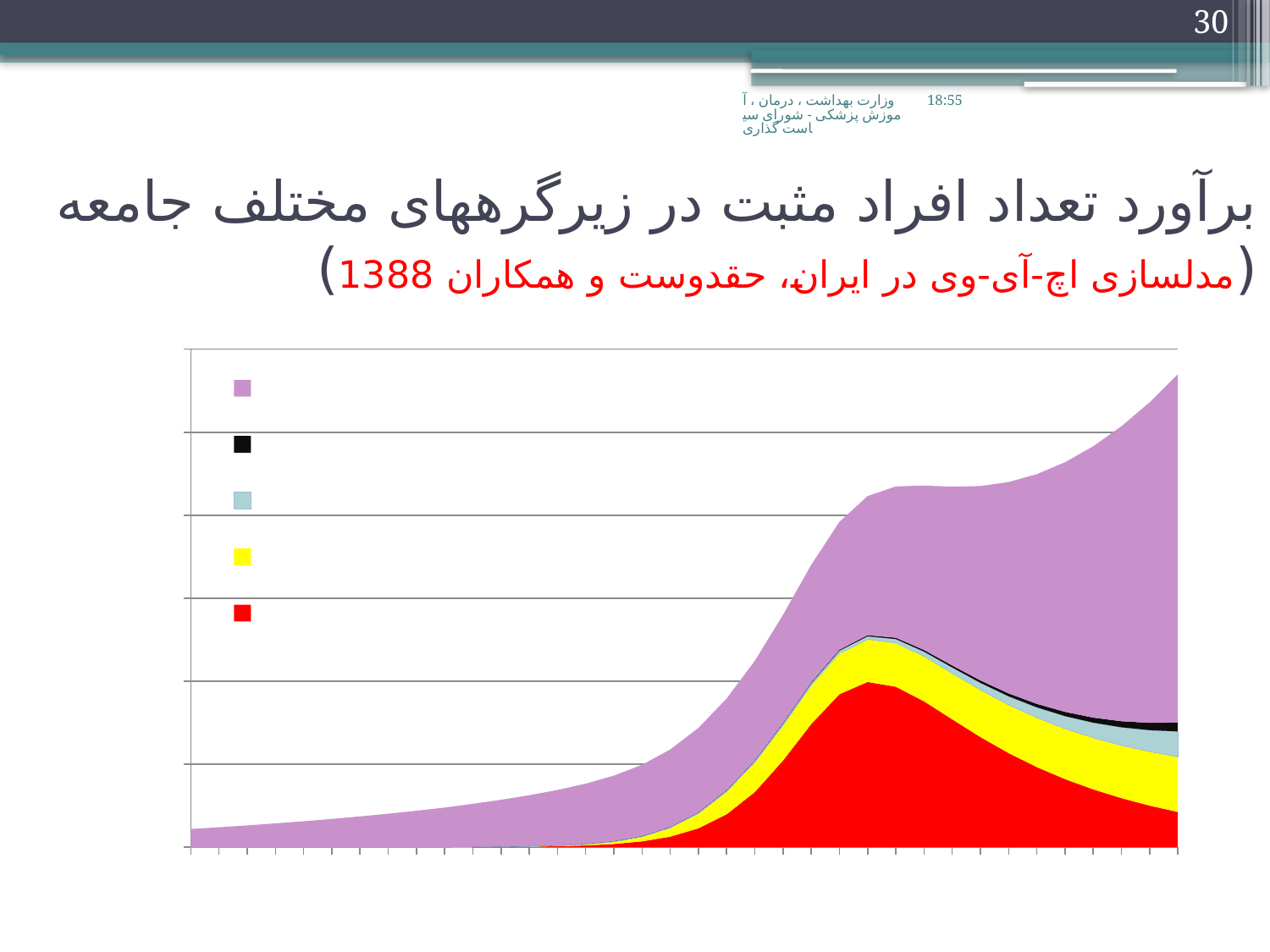
What year is given in the slide's subtitle for the HIV modelling study? 1388 Which colour occupies the largest area in the chart? purple What kind of chart is shown on the slide? area chart Does the total plotted value rise or fall along the x axis overall? rise After its peak, does the red series rise or fall toward the right end of the x axis? fall How many series does the chart's legend list? 5